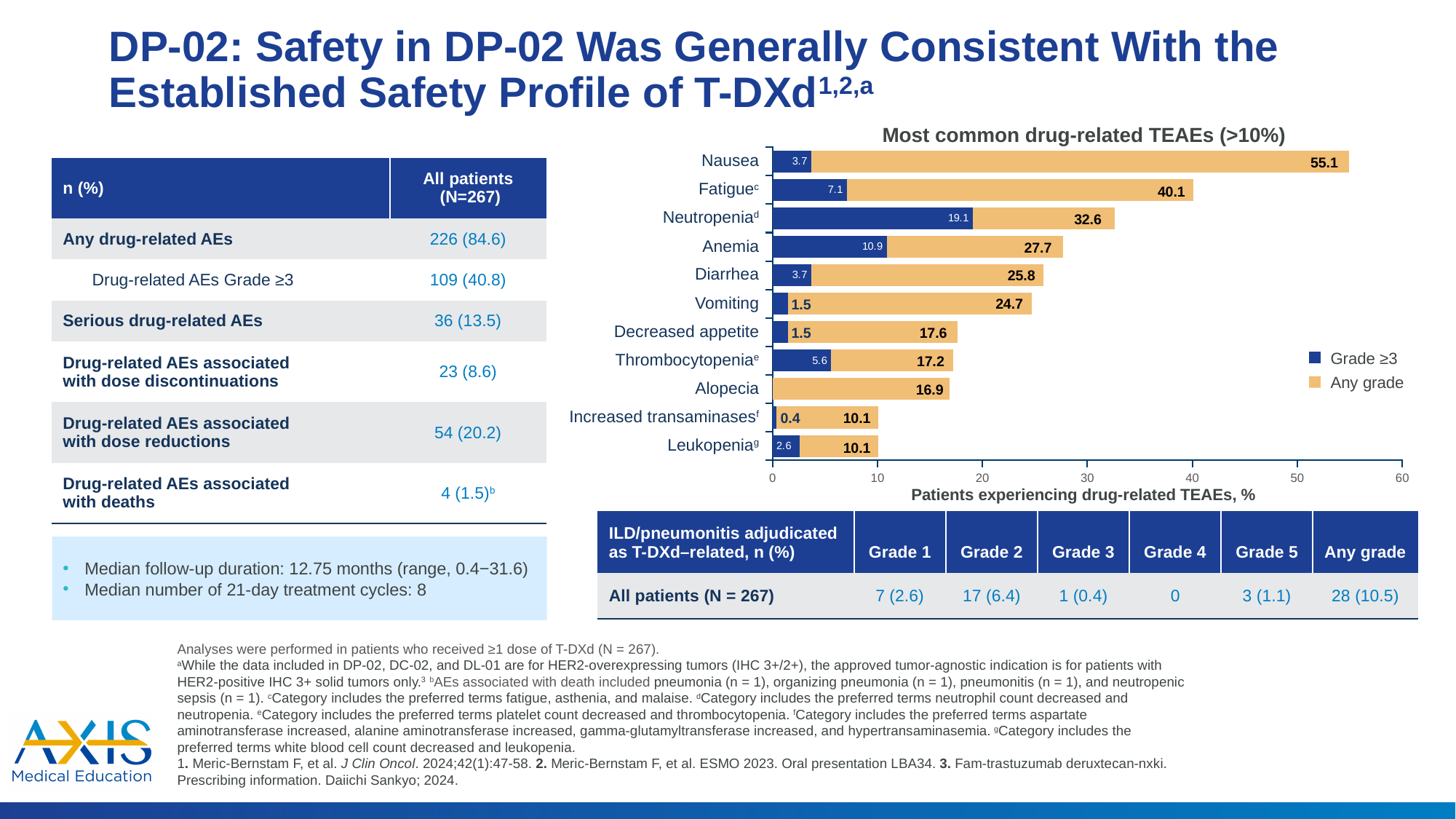
How many series does the chart legend list? 2 Which adverse event has the highest Grade ≥3 value in the chart? Neutropenia Which has a larger Any grade value, Anemia or Diarrhea? Anemia What type of chart is used to show the most common drug-related TEAEs? Bar chart What is the Any grade value for Alopecia in the chart? 16.9 What is the x-axis label of the chart? Patients experiencing drug-related TEAEs, % What is the Any grade value for Nausea in the chart? 55.1 Which adverse event has the highest Any grade value in the chart? Nausea How many adverse event categories are shown in the chart? 11 What is the Grade ≥3 value for Neutropenia in the chart? 19.1 Which adverse event has the lowest Grade ≥3 value shown in the chart? Increased transaminases What is the difference between the Any grade values for Nausea and Fatigue? 15.0